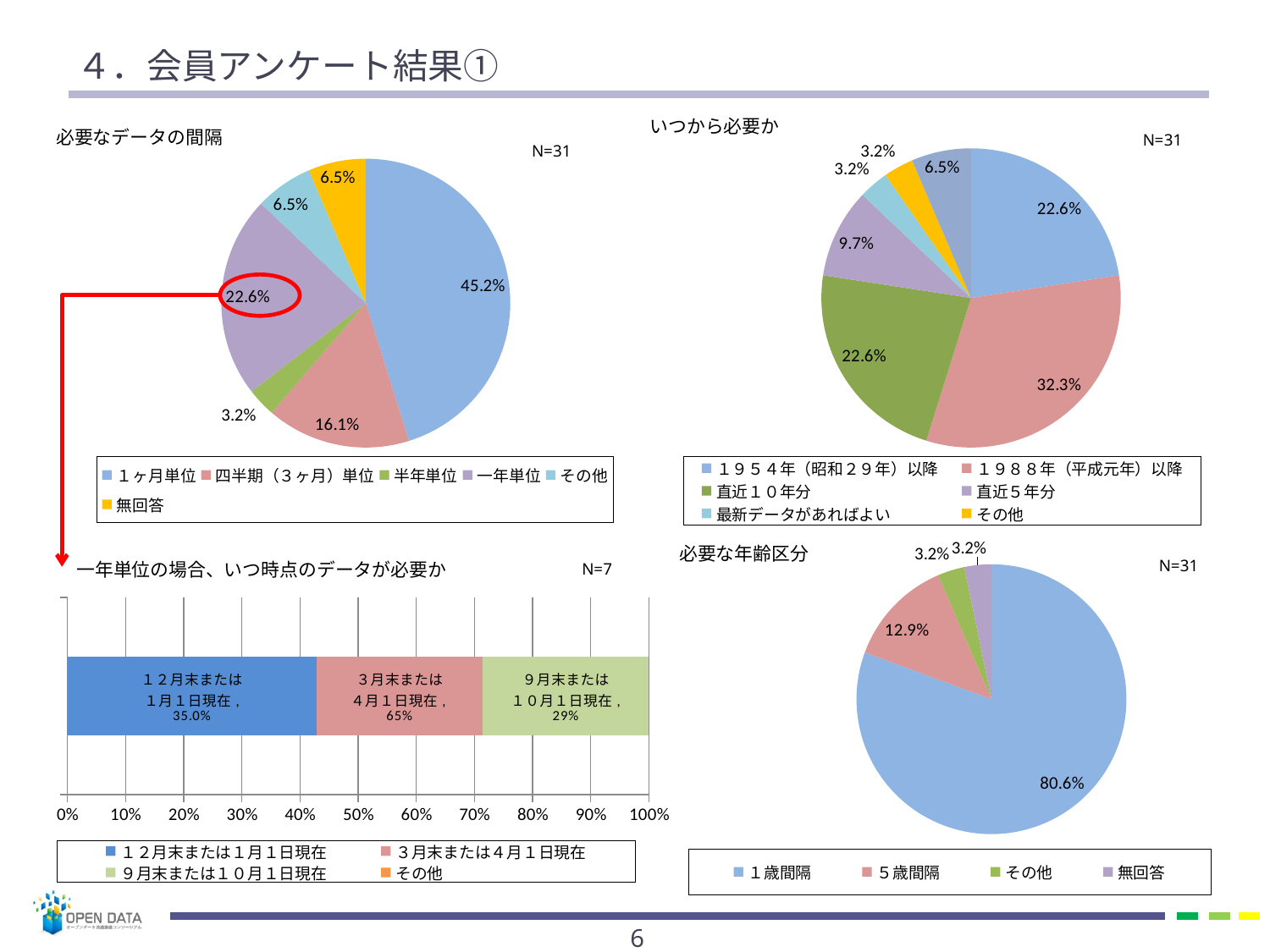
How many entries does the legend of the chart titled 一年単位の場合、いつ時点のデータが必要か list? 4 What kind of chart is the chart titled 一年単位の場合、いつ時点のデータが必要か? Bar chart In the pie chart titled 必要なデータの間隔, which category has the smallest slice? 半年単位 In the pie chart titled 必要なデータの間隔, what is the difference between the shares for 1ヶ月単位 and 四半期（3ヶ月）単位? 29.1% In the pie chart titled いつから必要か, which is larger, the slice for 1988年（平成元年）以降 or the slice for 直近10年分? 1988年（平成元年）以降 In the pie chart titled 必要なデータの間隔, what share is shown for 一年単位? 22.6% In the pie chart titled 必要な年齢区分, what is the difference between the shares for 1歳間隔 and 5歳間隔? 67.7% In the pie chart titled 必要なデータの間隔, what share is shown for 1ヶ月単位? 45.2% In the pie chart titled 必要な年齢区分, what share is shown for 1歳間隔? 80.6% In the pie chart titled 必要なデータの間隔, which category has the largest slice? 1ヶ月単位